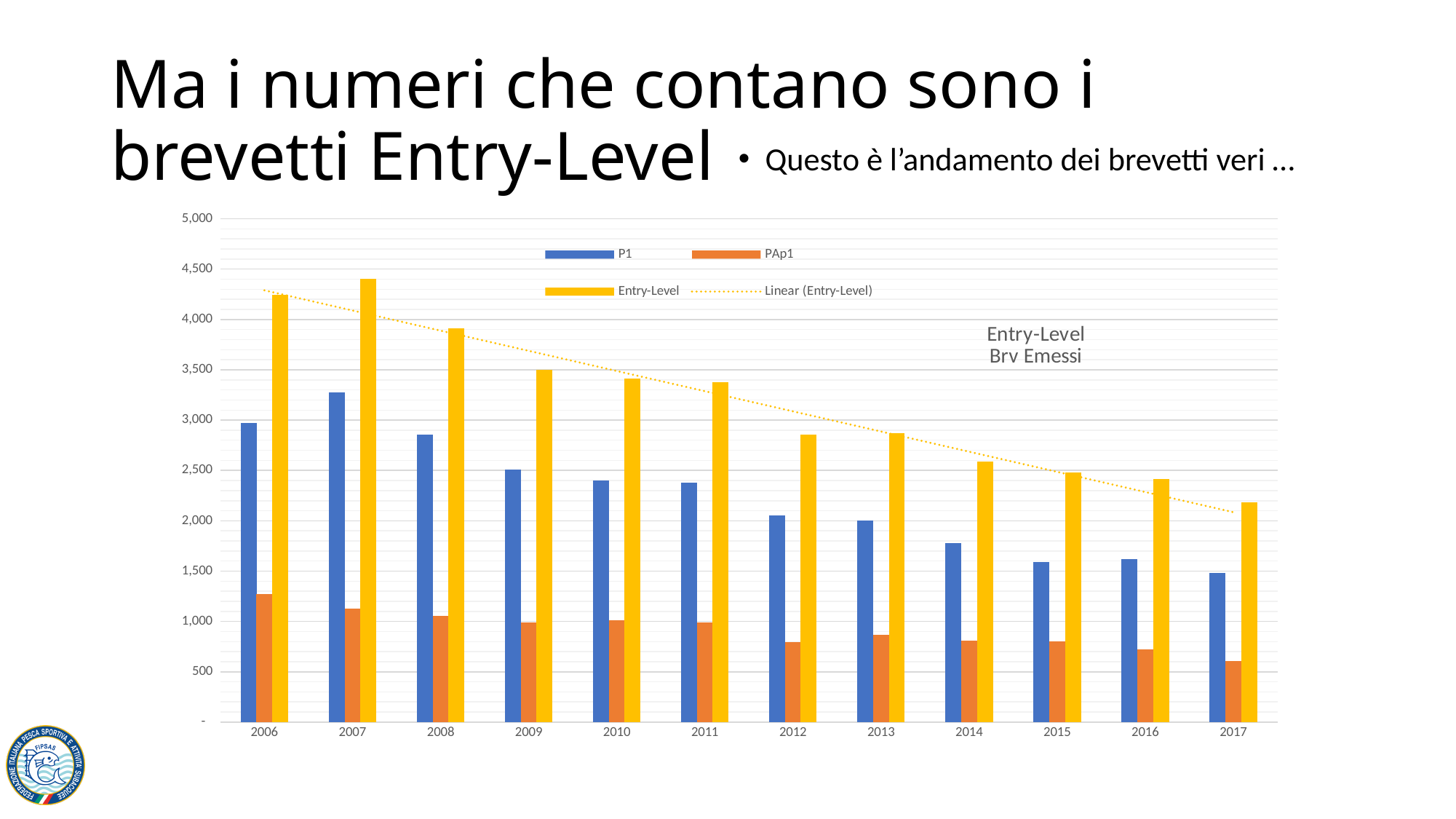
Is the Entry-Level value for 2006 greater or less than 4,000? greater Which year has the lowest Entry-Level value? 2017 Which year has the lowest PAp1 value? 2017 Is the P1 value for 2014 greater or less than 2,000? less What kind of chart is shown on the slide? Bar chart Is the PAp1 value for 2006 greater or less than 1,000? greater Do the Entry-Level values generally rise or fall from 2006 to 2017? fall How many entries does the chart legend list? 4 Which is larger, the P1 value for 2007 or the P1 value for 2008? 2007 Which year has the highest Entry-Level value? 2007 How many years are shown on the x axis of the chart? 12 Which year has the highest P1 value? 2007